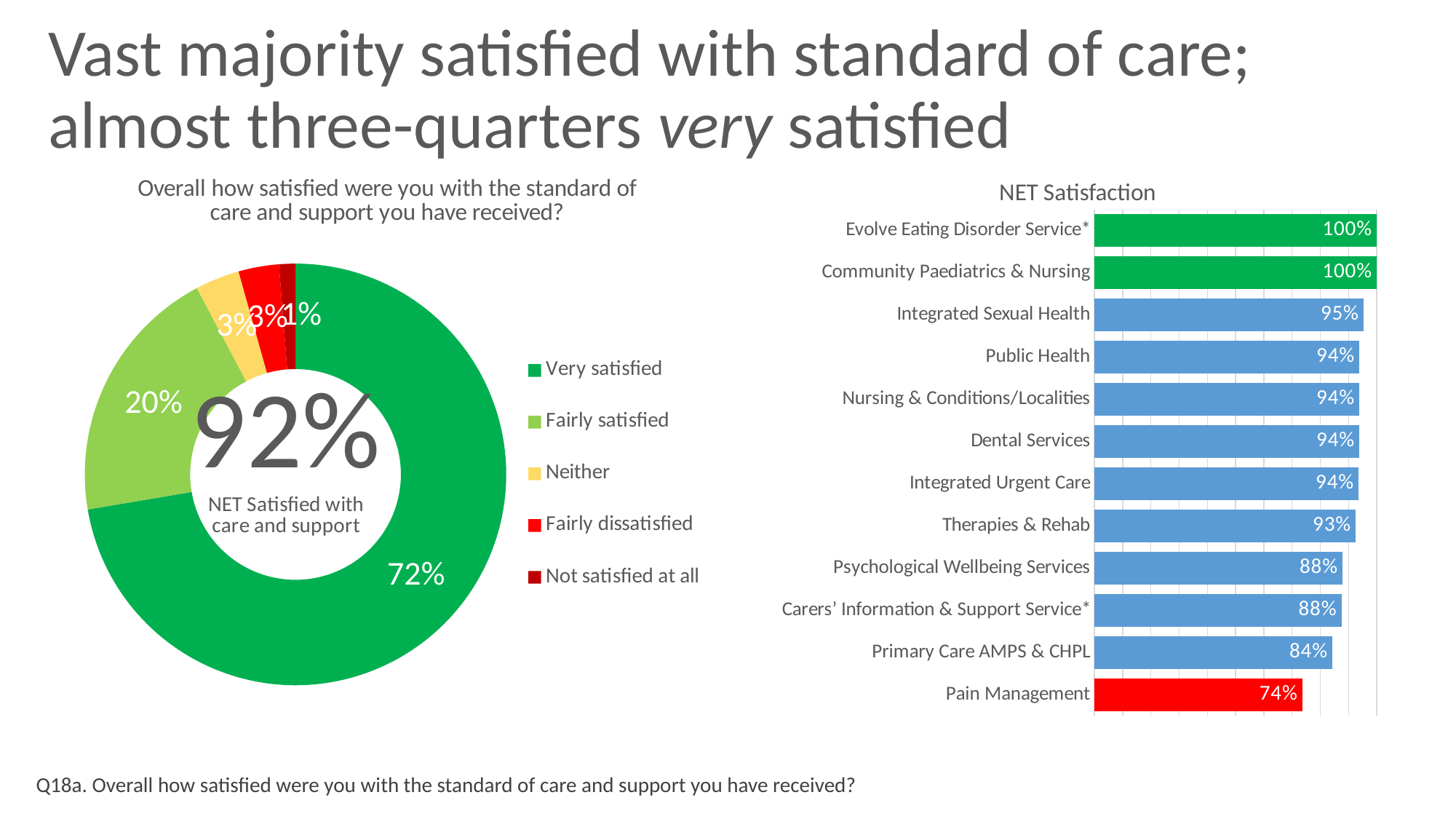
In the NET Satisfaction chart, how many services have a value of 100%? 2 What NET Satisfied figure is shown in the centre of the left-hand chart? 92% In the chart titled 'Overall how satisfied were you with the standard of care and support you have received?', what share is Very satisfied? 72% How many entries does the legend of the left-hand chart list? 5 How many services are listed in the NET Satisfaction chart? 12 In the NET Satisfaction chart, which is larger: Therapies & Rehab or Psychological Wellbeing Services? Therapies & Rehab In the NET Satisfaction chart, what is the value for Integrated Sexual Health? 95% In the NET Satisfaction chart, what is the value for Pain Management? 74% What kind of chart is the NET Satisfaction chart? Bar chart In the chart titled 'Overall how satisfied were you with the standard of care and support you have received?', what share is Fairly satisfied? 20% In the NET Satisfaction chart, what is the difference between Integrated Sexual Health and Primary Care AMPS & CHPL? 11% In the NET Satisfaction chart, which service has the lowest value? Pain Management